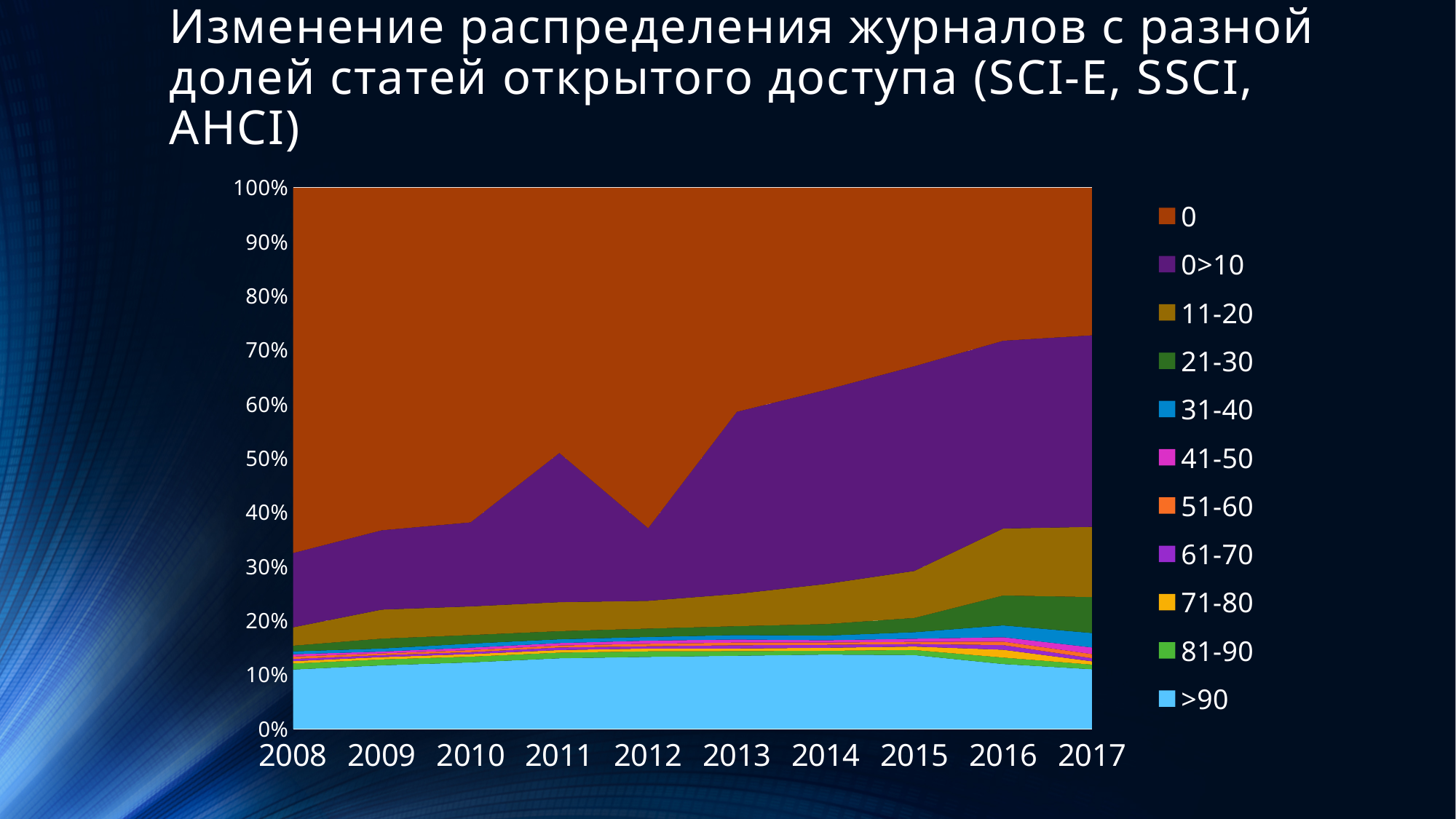
Which legend entry is listed last in the chart's legend? >90 In 2017, which series has the larger share: "0" or "0>10"? 0>10 What is the last year shown on the x axis? 2017 What kind of chart is shown on the slide? Stacked area chart Does the share of the "0>10" series rise or fall overall from 2008 to 2017? Rise Is the share of the ">90" series in 2015 greater or less than 10%? greater What is the first year shown on the x axis? 2008 Does the share of the "0" series rise or fall from 2008 to 2017? Fall In 2008, which series has the larger share: "0" or "0>10"? 0 Which series has the largest share in 2008? 0 How many years are shown along the x axis of the chart? 10 How many series does the chart's legend list? 11